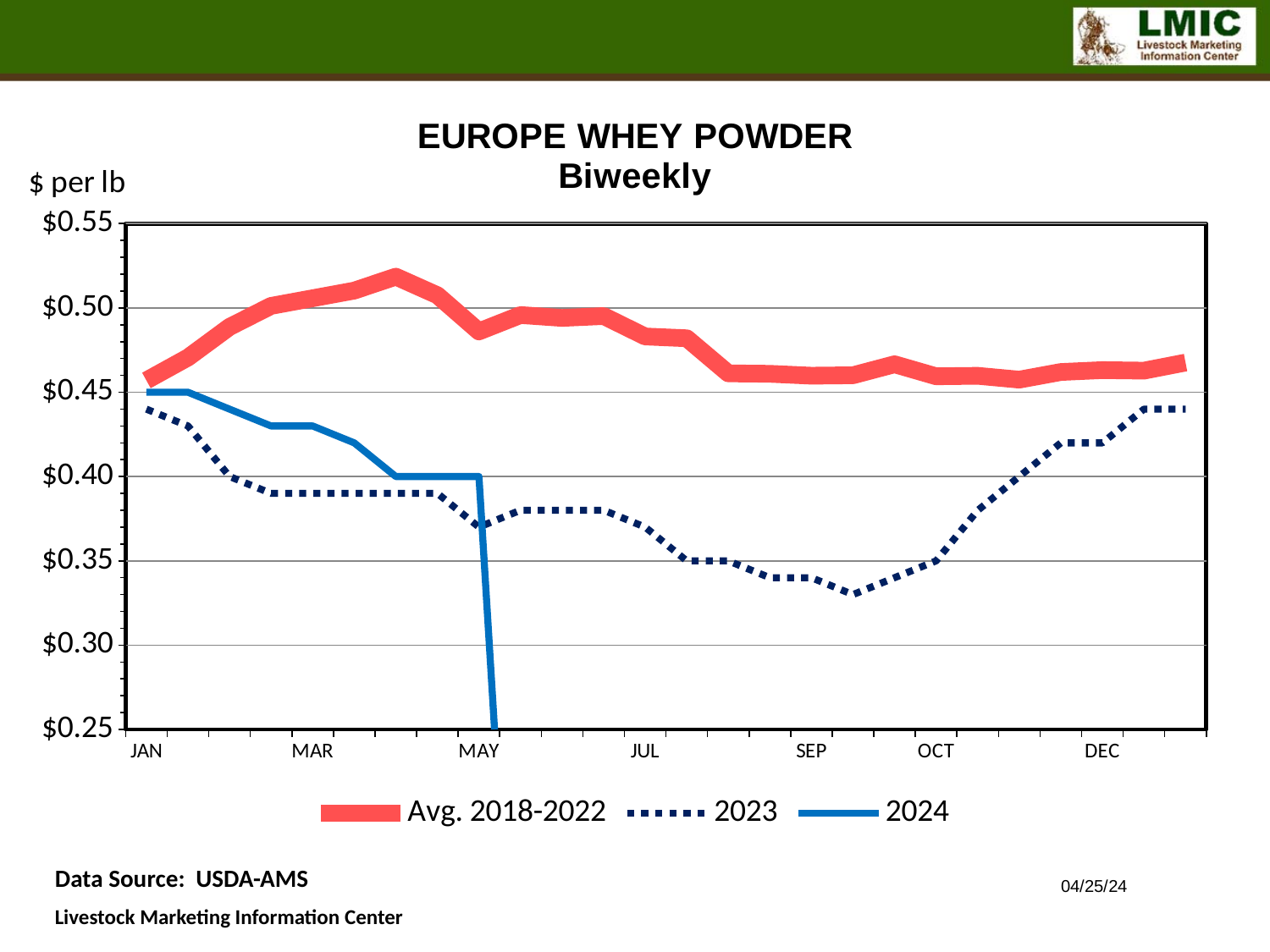
What unit is shown on the y axis of the chart? $ per lb In JAN, which is higher: Avg. 2018-2022 or 2023? Avg. 2018-2022 Is the 2024 value in MAR greater or less than $0.40? greater Does the 2024 line rise or fall from JAN to MAY? fall How many series does the legend list? 3 Is the 2023 value in JAN greater or less than $0.45? less What kind of chart is shown on the slide? line chart Is the Avg. 2018-2022 value in JUL greater or less than $0.45? greater In MAR, which is higher: the 2024 line or the 2023 line? 2024 Does the 2023 line rise or fall from OCT to DEC? rise Which series has the highest values across the whole year? Avg. 2018-2022